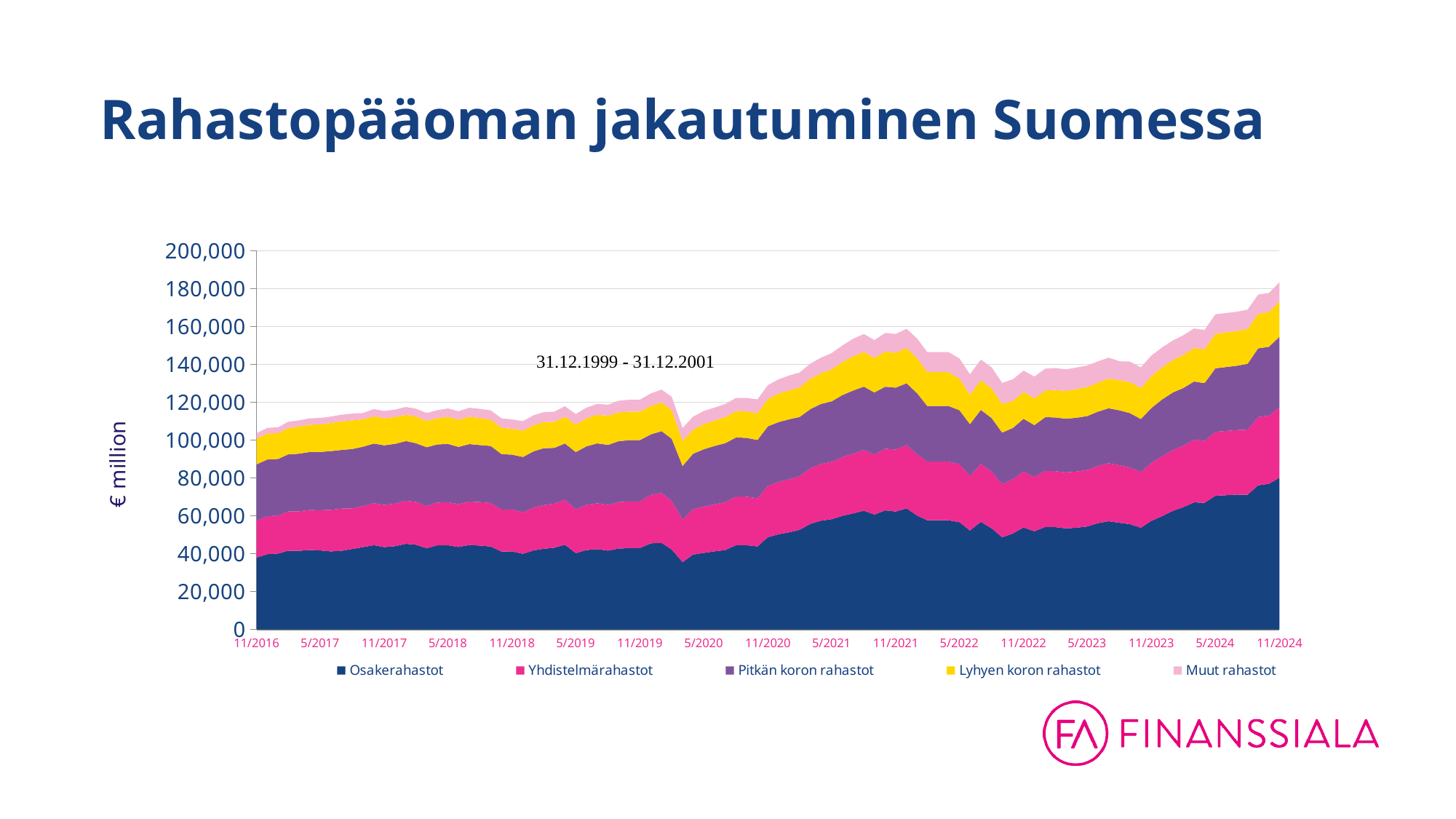
Is the total of all series at 5/2020 greater or less than 100,000? greater Is the value for Osakerahastot at 5/2024 greater or less than 60,000? greater Which series is the largest at 11/2024? Osakerahastot What kind of chart is shown on the slide? Stacked area chart At 11/2024, which is larger: Osakerahastot or Yhdistelmärahastot? Osakerahastot Is the total of all series at 11/2021 greater or less than 140,000? greater What is the label on the vertical axis? € million What is the title of the chart? Rahastopääoman jakautuminen Suomessa How many date labels are shown on the horizontal axis? 17 Does the Osakerahastot series rise or fall overall from 11/2016 to 11/2024? rise How many series does the legend list? 5